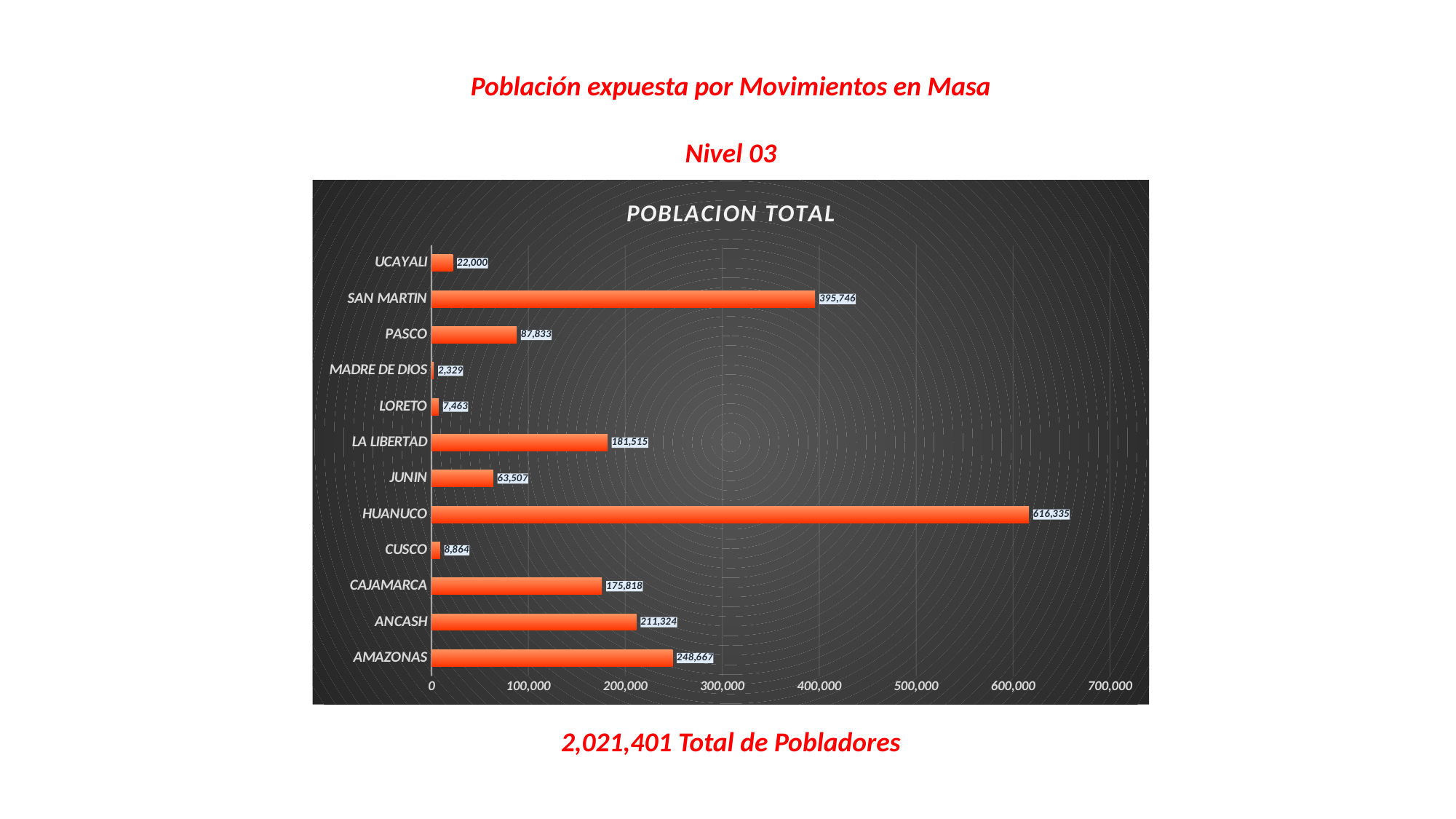
What is the difference between the values for HUANUCO and SAN MARTIN? 220,589 Which category has the lowest value? MADRE DE DIOS Which is larger, the value for LA LIBERTAD or the value for CAJAMARCA? LA LIBERTAD What is the value for SAN MARTIN? 395,746 What is the difference between the values for AMAZONAS and ANCASH? 37,343 Which category has the highest value? HUANUCO What kind of chart is shown on the slide? bar chart What is the value for MADRE DE DIOS? 2,329 What is the value for CAJAMARCA? 175,818 What is the value for HUANUCO? 616,335 Is the value for PASCO greater or less than 100,000? less How many categories are shown in the chart? 12